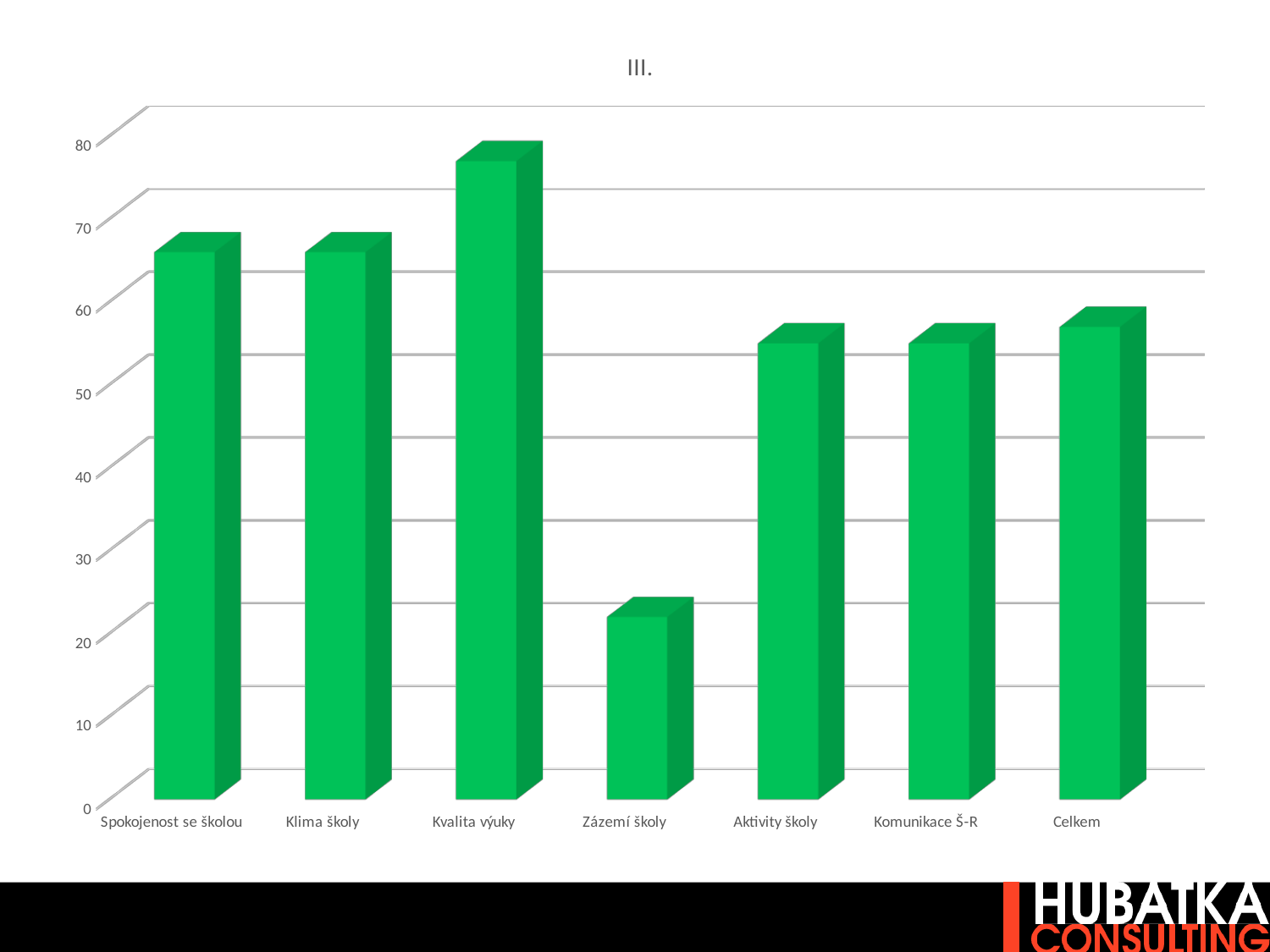
Which is larger, the value for Klima školy or the value for Komunikace Š-R? Klima školy Is the value for Spokojenost se školou greater or less than 60? greater Is the value for Aktivity školy greater or less than 50? greater Which category has the highest value in the chart? Kvalita výuky Which is larger, the value for Kvalita výuky or the value for Zázemí školy? Kvalita výuky What kind of chart is shown on the slide? bar chart Is the value for Celkem greater or less than 70? less How many categories are shown on the x axis of the chart? 7 Which category has the lowest value in the chart? Zázemí školy What is the title of the chart? III.